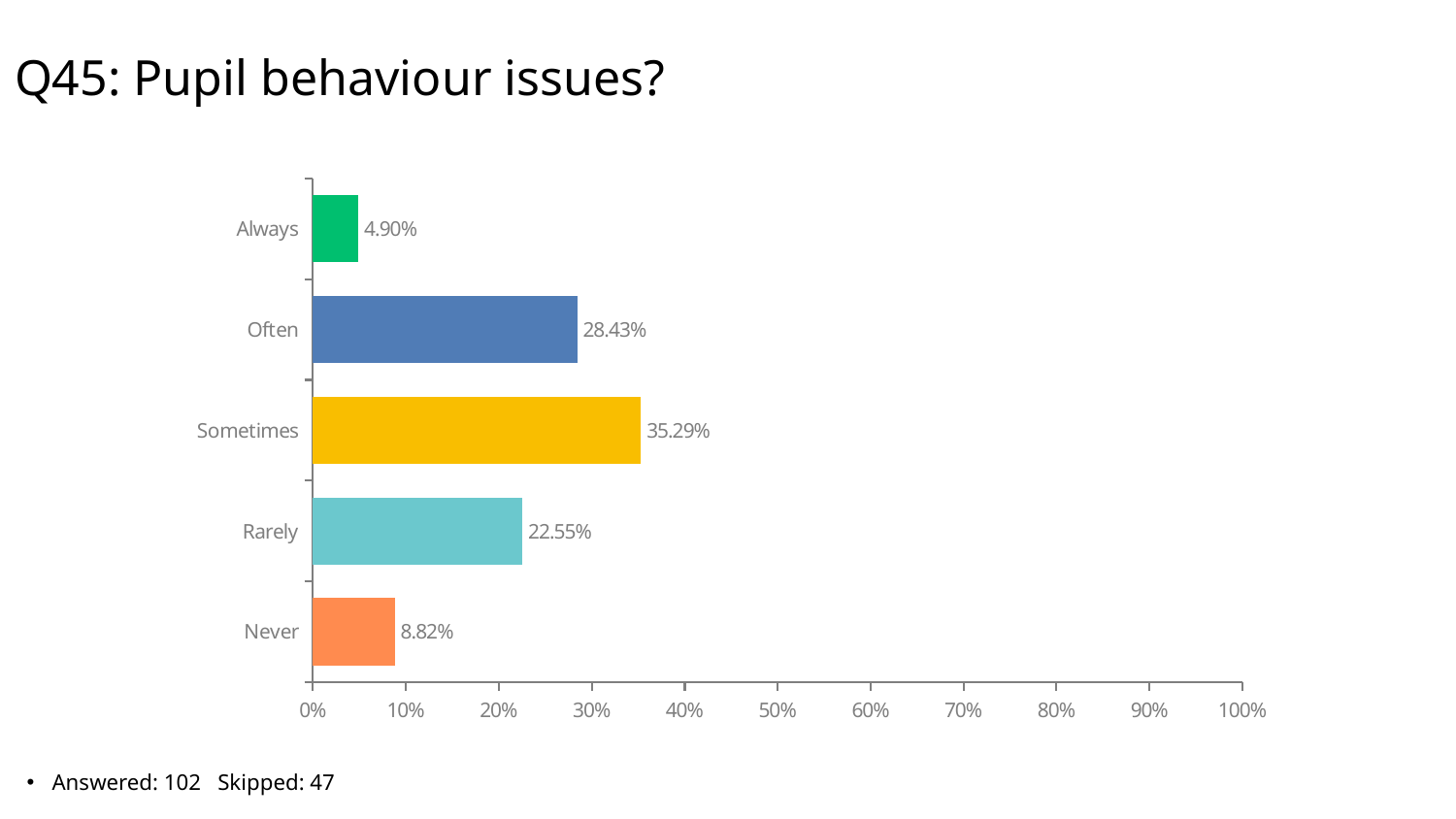
Which is larger, the value for 'Often' or the value for 'Rarely'? Often Which category has the lowest percentage? Always What colour is the bar for 'Sometimes'? Yellow What is the title of the slide? Q45: Pupil behaviour issues? What is the value shown for 'Never'? 8.82% What is the value shown for 'Always'? 4.90% What is the difference between the 'Often' and 'Rarely' percentages? 5.88% Which category has the highest percentage? Sometimes What percentage of respondents answered 'Sometimes' to Q45: Pupil behaviour issues? 35.29% Is the value for 'Sometimes' greater or less than 30%? greater What kind of chart is shown on the slide? Bar chart How many categories are shown in the chart? 5